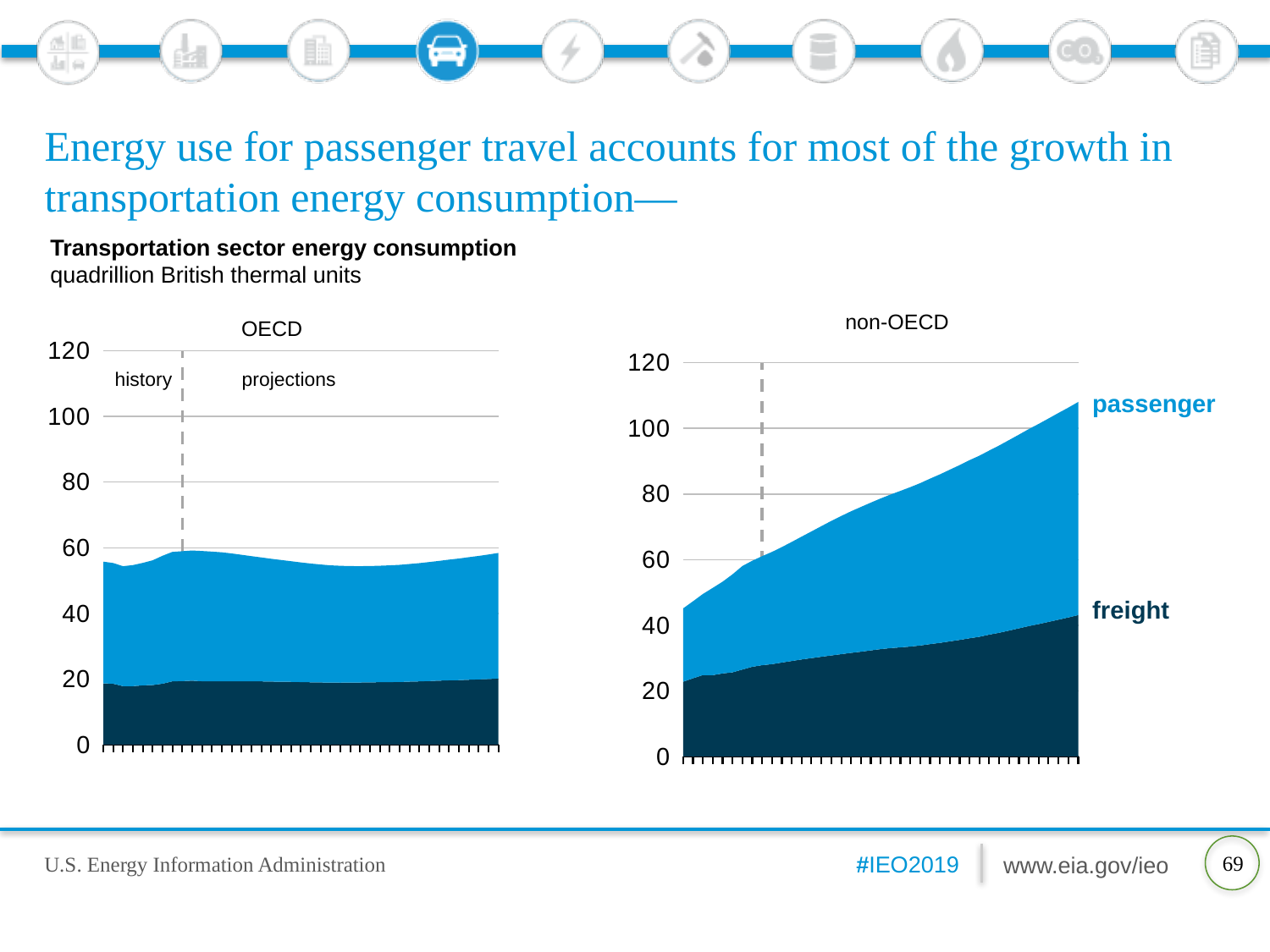
In the OECD chart, is the total transportation energy consumption at the end of the projection period greater or less than 40? greater What unit is used for the charts on this slide? quadrillion British thermal units In the non-OECD chart, is the total transportation energy consumption at the start of the period greater or less than 60? less In the non-OECD chart, which series is larger at the end of the projection period, passenger or freight? passenger What kind of chart is the OECD chart? stacked area chart In the non-OECD chart, does total transportation energy consumption rise or fall over the projection period? rise In the non-OECD chart, is the freight energy consumption at the end of the projection period greater or less than 60? less What are the two series labelled on the non-OECD chart? passenger and freight At the end of the projection period, which chart shows the higher total transportation energy consumption, OECD or non-OECD? non-OECD How many series are shown in the non-OECD chart? 2